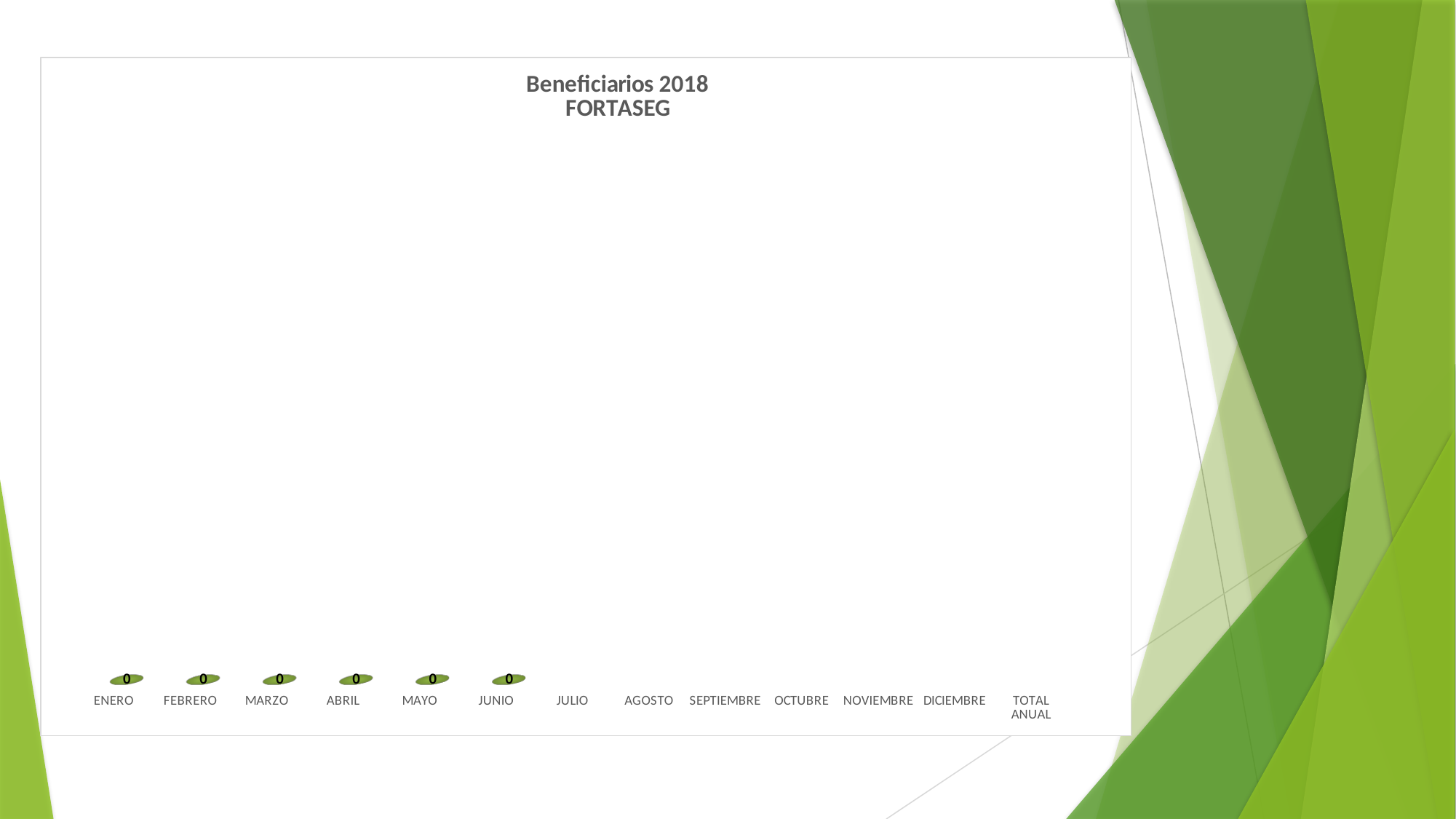
What is the difference between the values for ENERO and JUNIO? 0 What is the value shown for ENERO? 0 How many categories have a data label printed on the chart? 6 What is the value shown for FEBRERO? 0 What is the value shown for MARZO? 0 What is the value shown for ABRIL? 0 What type of chart is shown on the slide? bar chart What is the value shown for MAYO? 0 How many categories are listed along the x axis? 13 What is the value shown for JUNIO? 0 What is the title of the chart? Beneficiarios 2018 FORTASEG What is the label of the last category on the x axis? TOTAL ANUAL